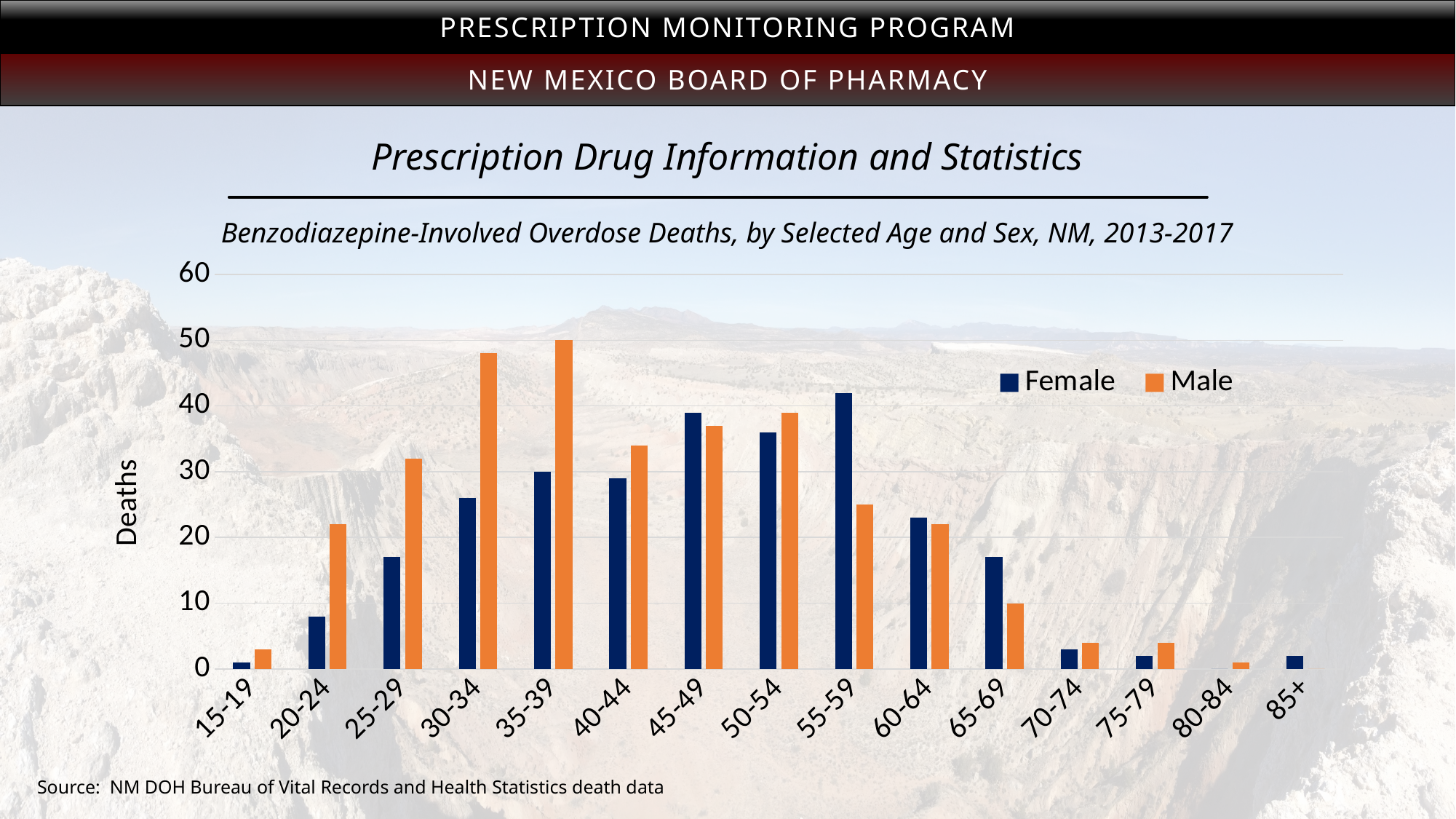
Is the Male value for the 30-34 age group greater or less than 40? greater Which age group has the highest Male value? 35-39 What is the Male value for the 35-39 age group? 50 What type of chart is shown on the slide? Bar chart Is the Male value for the 55-59 age group greater or less than 30? less How many series does the legend list? 2 For the 55-59 age group, which is larger, the Female or the Male value? Female For the 30-34 age group, which is larger, the Female or the Male value? Male How many age groups are shown on the x axis? 15 Do the Male values rise or fall from the 35-39 age group to the 80-84 age group? Fall Which age group has the highest Female value? 55-59 Is the Female value for the 20-24 age group greater or less than 10? less